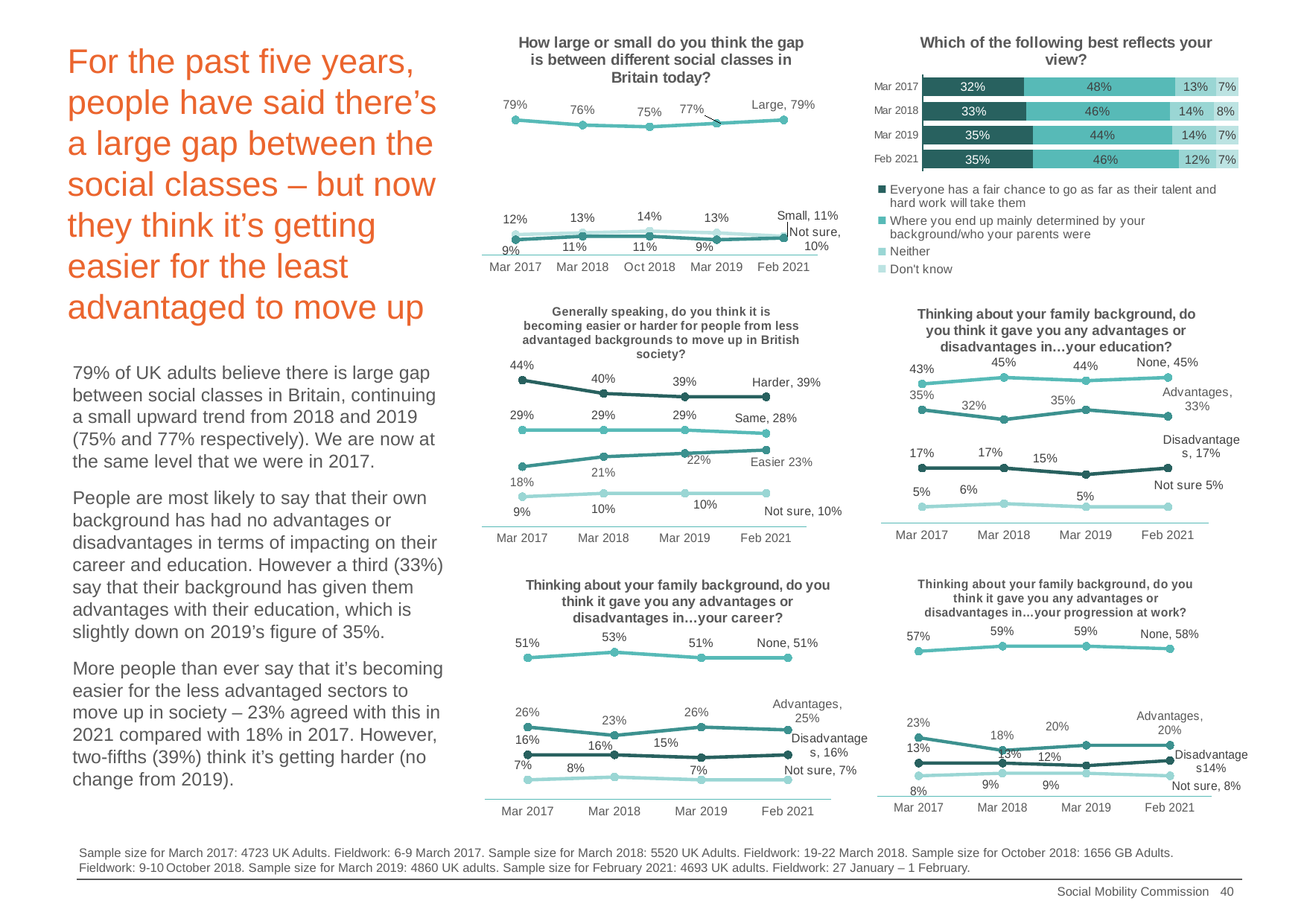
In the chart 'Which of the following best reflects your view?', what percentage in Mar 2019 said 'Where you end up mainly determined by your background/who your parents were'? 44% What kind of chart is 'Which of the following best reflects your view?' Stacked bar chart In the chart about advantages or disadvantages in your progression at work, which response has the lowest value in Feb 2021? Not sure, 8% In the chart about advantages or disadvantages in your career, which is larger in Mar 2018: 'Advantages' or 'Disadvantages'? Advantages (23%) In the chart 'Generally speaking, do you think it is becoming easier or harder for people from less advantaged backgrounds to move up in British society?', what is the difference between the 'Harder' value in Mar 2017 and in Feb 2021? 5 percentage points In the chart 'How large or small do you think the gap is between different social classes in Britain today?', how many time points are shown on the x axis? 5 In the chart about advantages or disadvantages in your progression at work, what percentage said 'None' in Mar 2018? 59% In the chart 'Generally speaking, do you think it is becoming easier or harder for people from less advantaged backgrounds to move up in British society?', does the 'Easier' series rise or fall from Mar 2017 to Feb 2021? Rises In the chart about advantages or disadvantages in your education, what percentage said 'Disadvantages' in Mar 2019? 15% In the chart 'Which of the following best reflects your view?', how many entries does the legend list? 4 In the chart 'How large or small do you think the gap is between different social classes in Britain today?', what percentage said 'Large' in Oct 2018? 75% In the chart about advantages or disadvantages in your education, which response has the highest value in Feb 2021? None, 45%